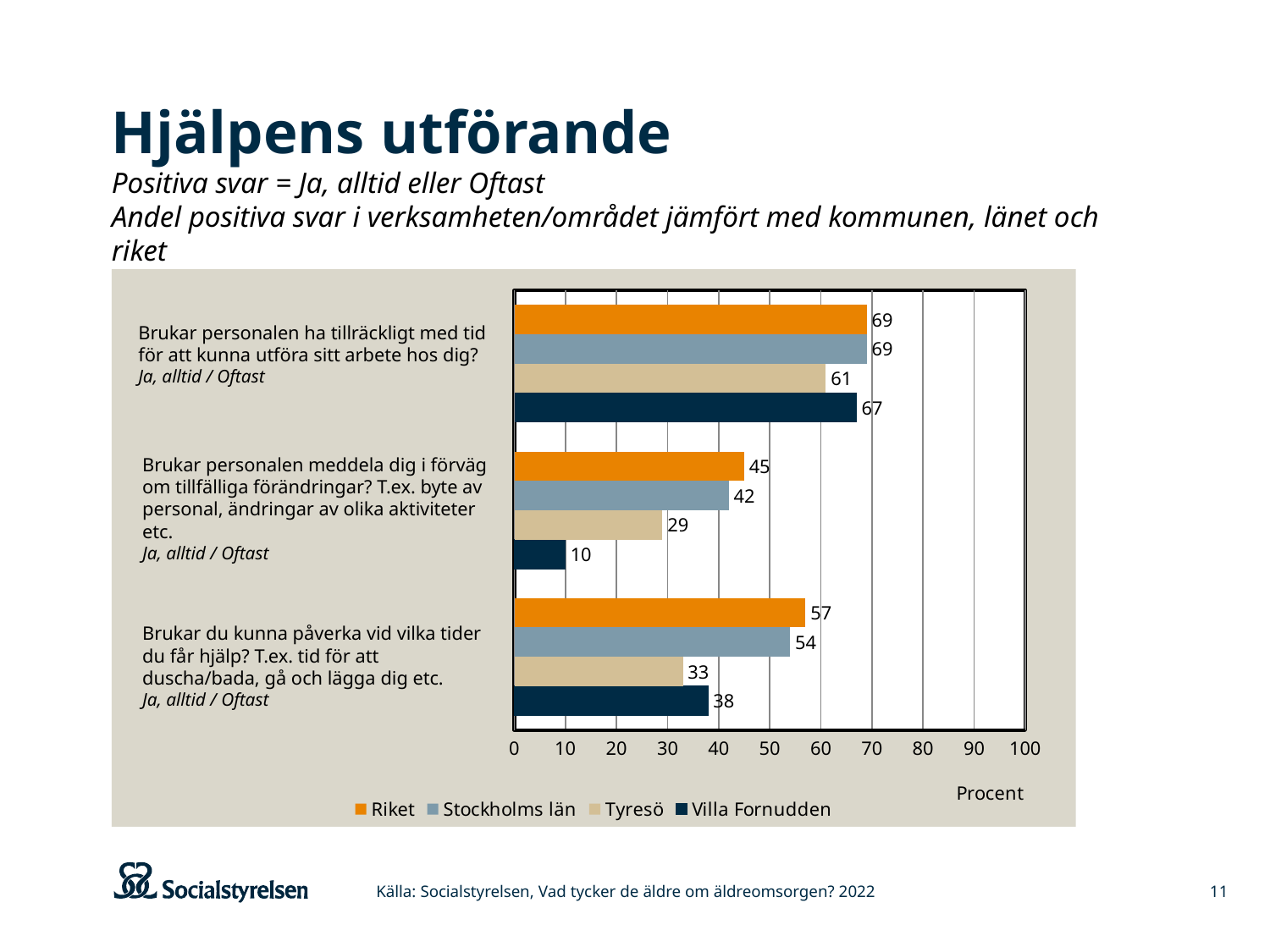
Which is larger on the question about being able to influence at what times you get help: Tyresö or Villa Fornudden? Villa Fornudden Is the value for Tyresö on the question about staff having enough time greater or less than 50? greater What unit is shown on the horizontal axis of the chart? Procent What is the value for Villa Fornudden on the question about whether staff usually have enough time to do their work? 67 What kind of chart is shown on the slide? Bar chart What is the difference between Stockholms län and Villa Fornudden on the question about staff informing you in advance of temporary changes? 32 Which series has the highest value on the question about being able to influence at what times you get help? Riket What is the value for Tyresö on the question about staff informing you in advance of temporary changes? 29 How many questions (categories) are shown on the chart? 3 How many series does the legend list? 4 Which series has the lowest value on the question about staff informing you in advance of temporary changes? Villa Fornudden What is the value for Riket on the question about being able to influence at what times you get help? 57